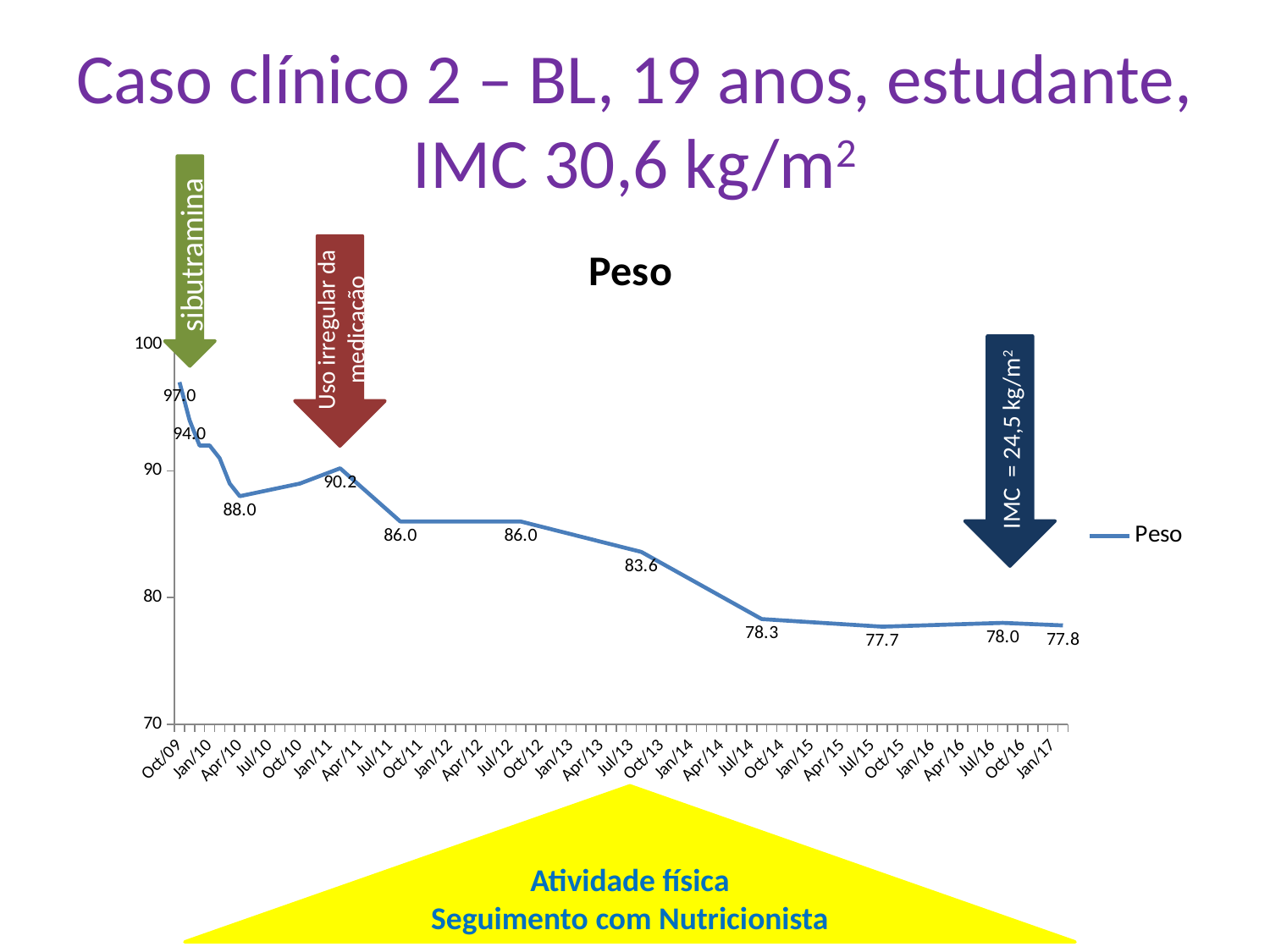
What is the value of the last data point (Jan/17) on the Peso line? 77.8 What is the difference between the first labelled value (97.0) and the last labelled value (77.8)? 19.2 What is the lowest labelled value on the Peso line? 77.7 What is the highest labelled value on the Peso line? 97.0 Which is larger, the labelled value 88.0 or the labelled value 90.2 that follows it? 90.2 What is the title of the chart? Peso Is the value for Jan/12 greater or less than 90? less What is the value of the first data point (Oct/09) on the Peso line? 97.0 What kind of chart is shown on the slide? line chart How many series does the legend list? 1 Overall, does the Peso line rise or fall from Oct/09 to Jan/17? fall What is the difference between the labelled values 97.0 and 94.0? 3.0